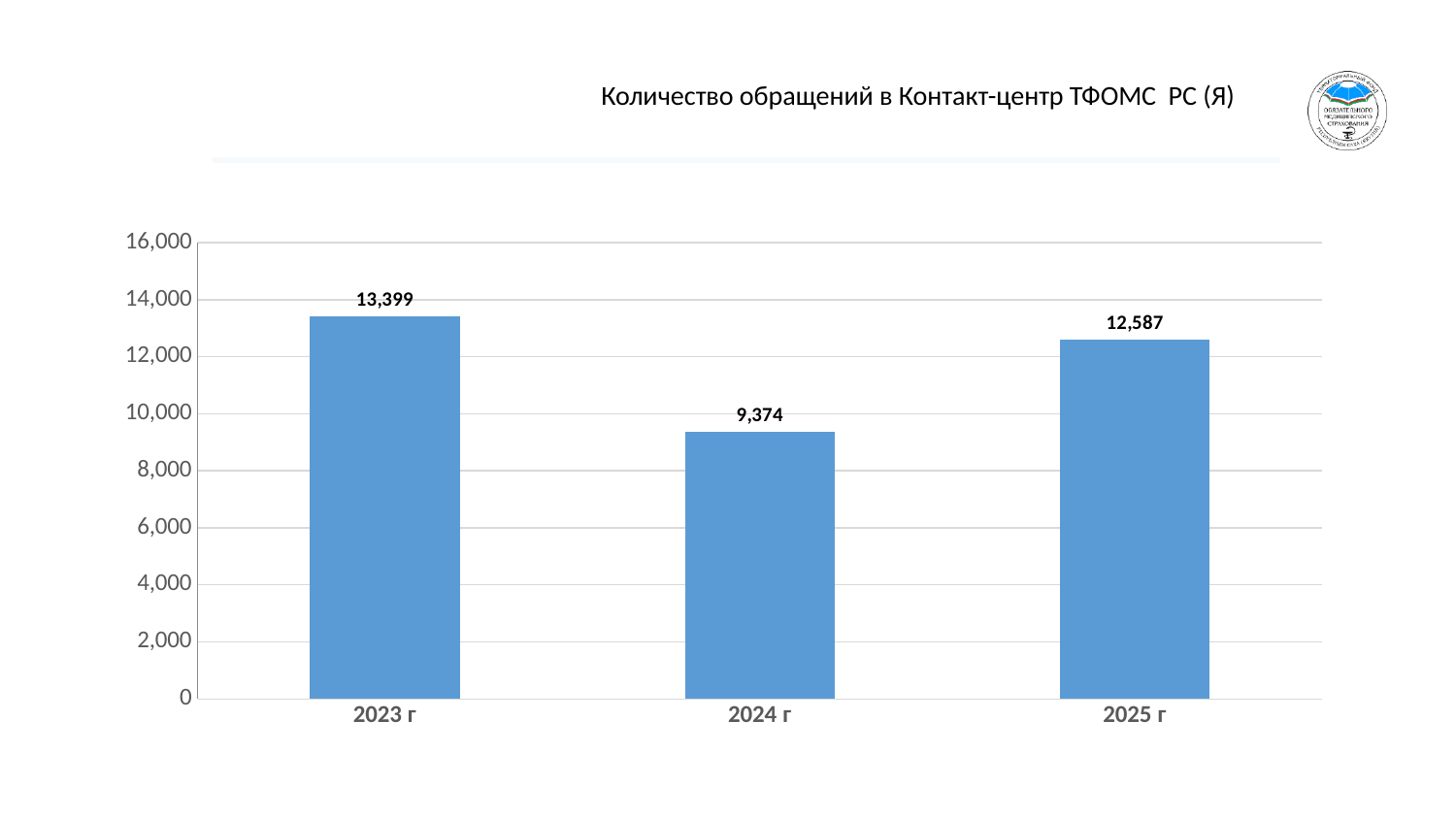
Is the value for 2024 г greater or less than 10,000? less What is the difference between the values for 2023 г and 2024 г? 4,025 Which is larger, the value for 2025 г or the value for 2024 г? 2025 г What is the title of the chart? Количество обращений в Контакт-центр ТФОМС РС (Я) What is the value for 2024 г? 9,374 What is the value for 2023 г? 13,399 What is the difference between the values for 2023 г and 2025 г? 812 Which year has the highest value? 2023 г Which year has the lowest value? 2024 г How many years are shown on the chart? 3 What kind of chart is shown on the slide? bar chart What is the value for 2025 г? 12,587